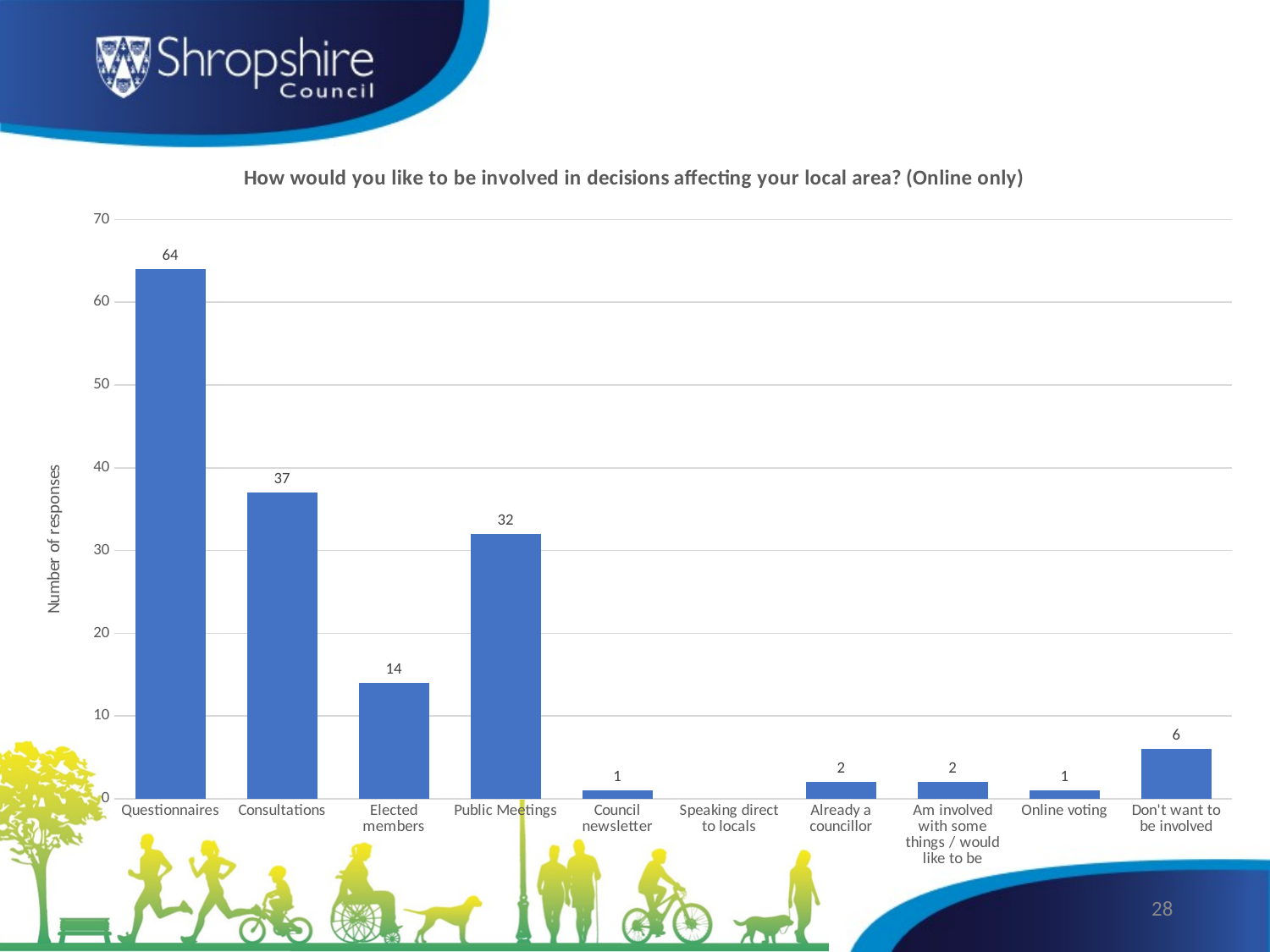
Which category has the highest number of responses? Questionnaires What is the label of the vertical axis? Number of responses What is the number of responses for Public Meetings? 32 What is the number of responses for Don't want to be involved? 6 What is the difference in responses between Consultations and Public Meetings? 5 What is the number of responses for Elected members? 14 What kind of chart is shown on the slide? Bar chart How many categories are shown on the x axis? 10 Which has more responses, Elected members or Public Meetings? Public Meetings What is the difference in responses between Questionnaires and Consultations? 27 What is the number of responses for Questionnaires? 64 Is the value for Consultations greater or less than 40? less